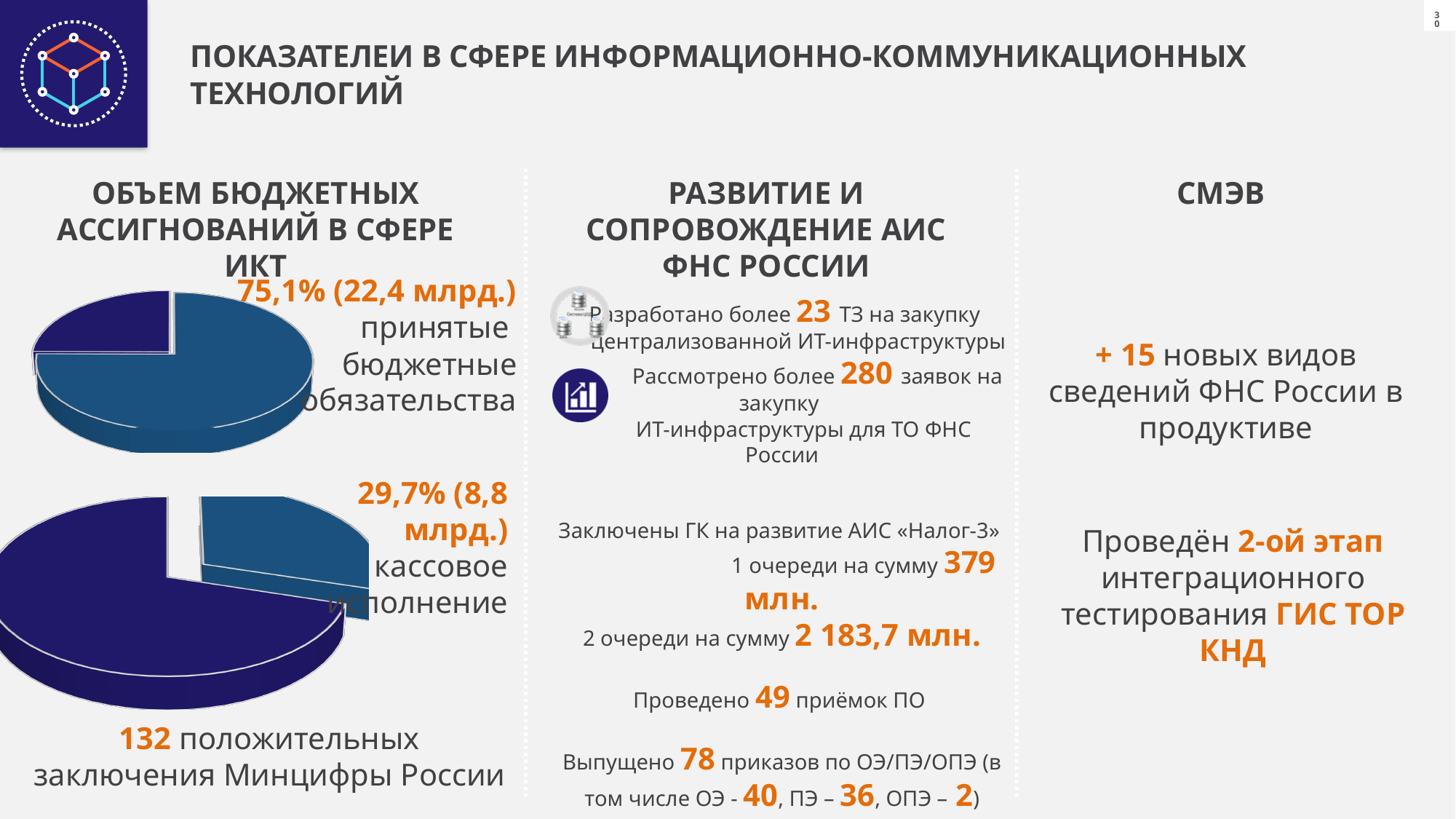
In the top pie chart, what share is labelled for принятые бюджетные обязательства? 75,1% Under which heading are the two pie charts placed on the slide? ОБЪЕМ БЮДЖЕТНЫХ АССИГНОВАНИЙ В СФЕРЕ ИКТ How many slices does the bottom pie chart have? 2 In the bottom pie chart, what share is labelled for кассовое исполнение? 29,7% In the bottom pie chart, is the light blue slice or the dark navy slice larger? dark navy In the top pie chart, is the share for принятые бюджетные обязательства greater or less than 50%? greater In the top pie chart, is the light blue slice or the dark navy slice larger? light blue In the bottom pie chart, what amount in млрд. is shown for кассовое исполнение? 8,8 млрд. In the top pie chart, what amount in млрд. is shown for принятые бюджетные обязательства? 22,4 млрд. What kind of chart is the top chart on the left of the slide? pie chart What kind of chart is the bottom chart on the left of the slide? pie chart How many slices does the top pie chart have? 2